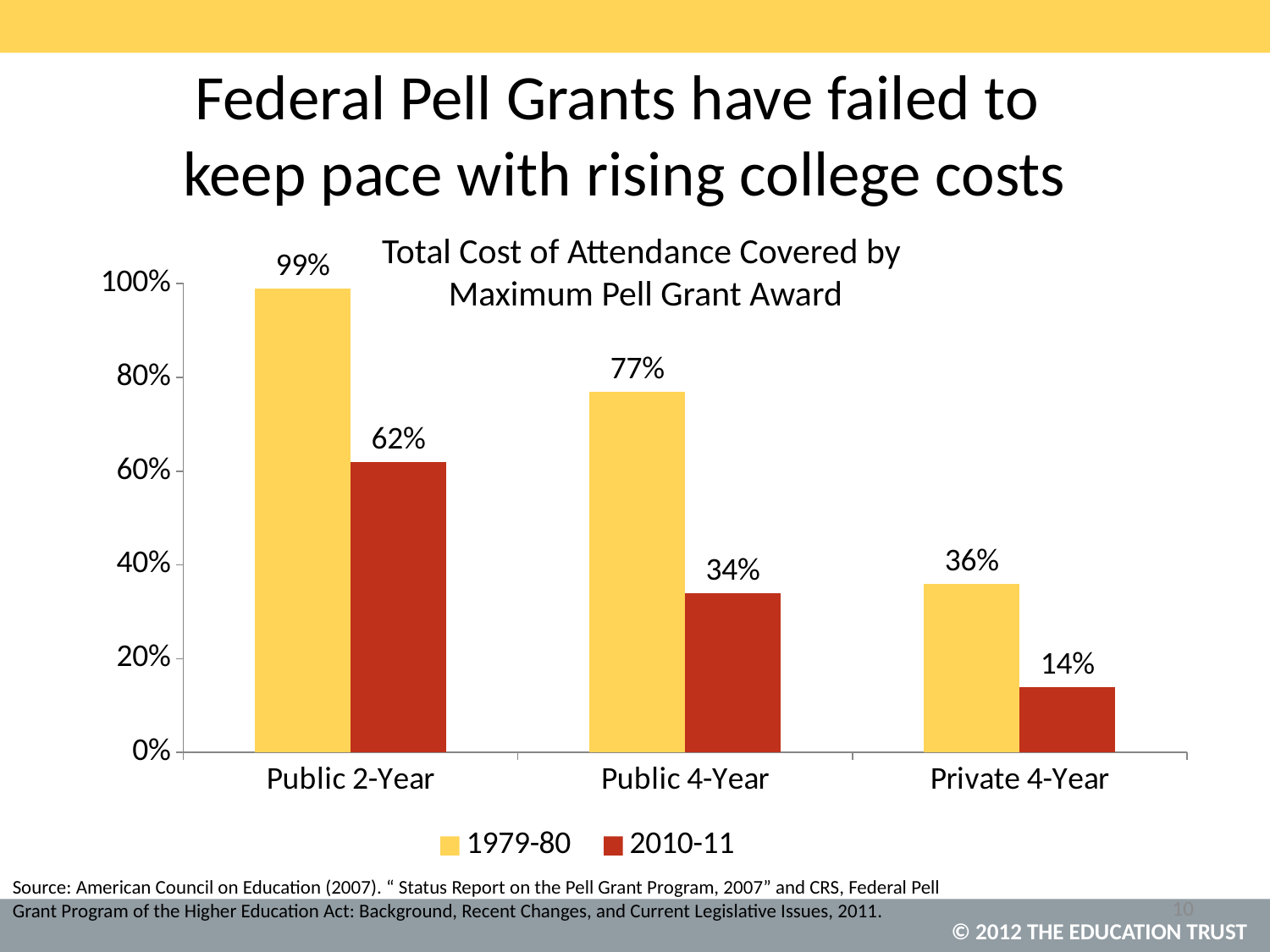
What is the difference between the 1979-80 and 2010-11 values for Public 4-Year? 43 percentage points What is the title of the chart? Total Cost of Attendance Covered by Maximum Pell Grant Award Which institution type has the lowest value for 2010-11? Private 4-Year What is the difference between the 1979-80 and 2010-11 values for Public 2-Year? 37 percentage points What is the value for Private 4-Year in 2010-11? 14% Which is larger: the 2010-11 value for Public 2-Year or the 1979-80 value for Private 4-Year? 2010-11 value for Public 2-Year What percentage of total cost of attendance was covered by the maximum Pell Grant award for Public 2-Year institutions in 1979-80? 99% What is the value for Public 4-Year in 2010-11? 34% How many series does the legend list? 2 What kind of chart is shown on the slide? Bar chart How many institution types are shown on the x axis? 3 Which institution type has the highest value for 1979-80? Public 2-Year